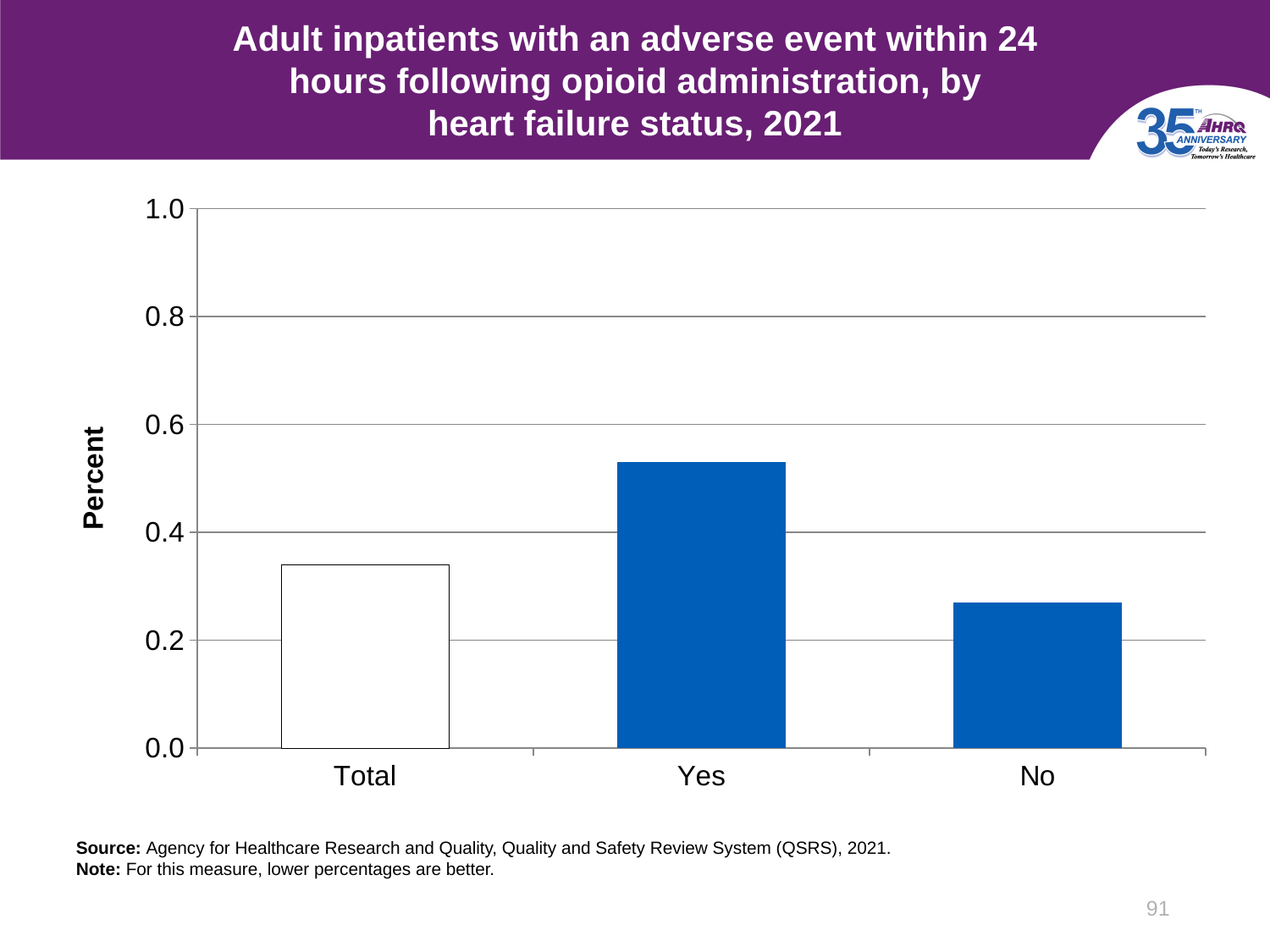
Which is larger, the value for Yes or the value for No? Yes Which category has the lowest value in the chart? No How many categories are shown on the x axis of the chart? 3 What year does the chart title say the data are from? 2021 What kind of chart is shown on the slide? bar chart Which is larger, the value for Total or the value for Yes? Yes Which category has the highest value in the chart? Yes Is the value for Yes greater or less than 0.4? greater Is the value for Yes greater or less than 0.6? less Is the value for No greater or less than 0.2? greater What is the label of the y axis of the chart? Percent